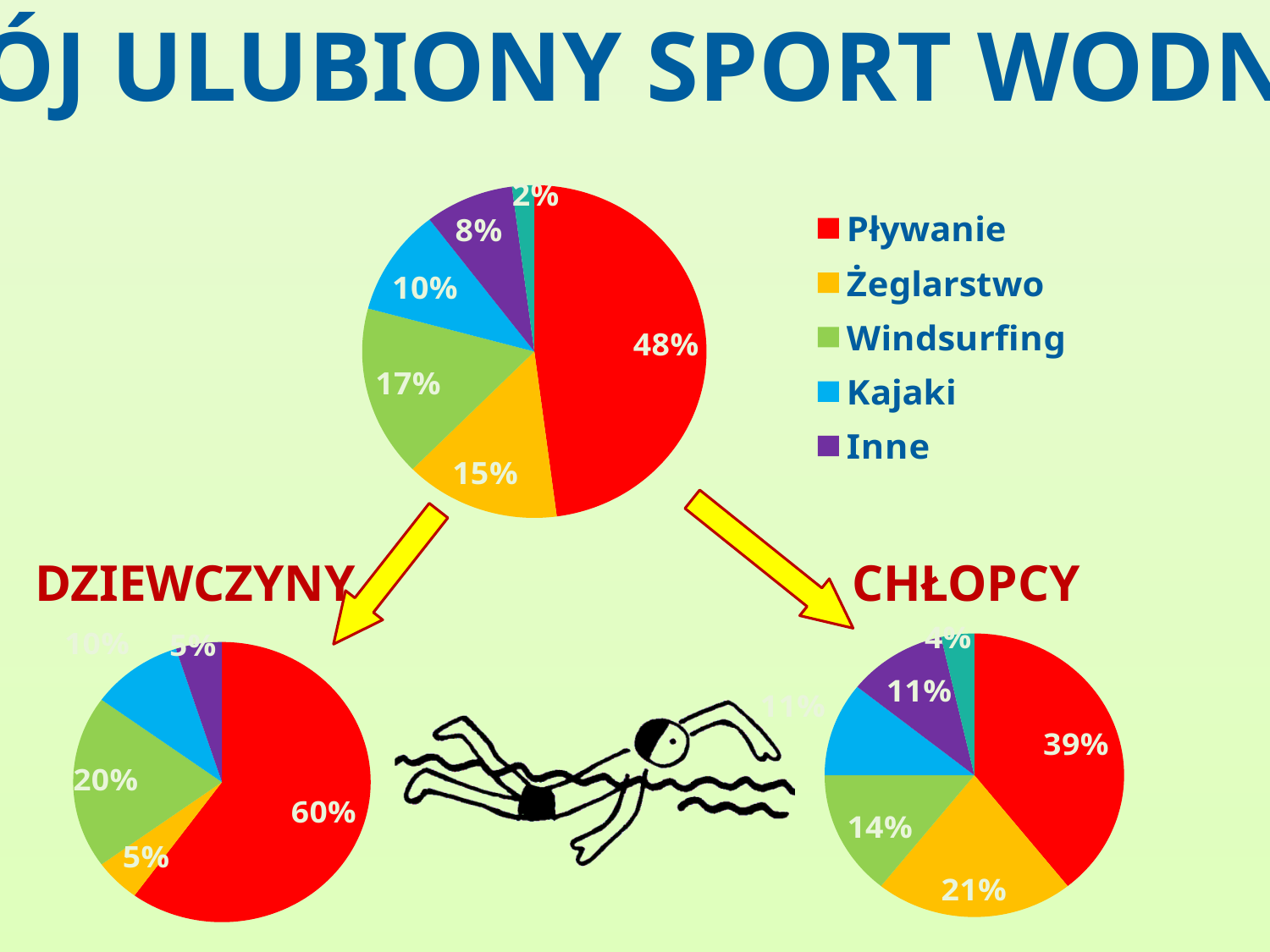
Which is larger: the share of Pływanie in the DZIEWCZYNY chart or in the CHŁOPCY chart? DZIEWCZYNY In the CHŁOPCY pie chart, what share does Windsurfing have? 14% Which colour represents Kajaki in the legend? blue In the top pie chart, which category has the largest share? Pływanie In the top pie chart, what is the difference between the shares of Żeglarstwo and Inne? 7% In the top pie chart, what share does Pływanie have? 48% What type of chart is used on this slide? pie chart In the DZIEWCZYNY pie chart, what share does Pływanie have? 60% In the DZIEWCZYNY pie chart, what share does Windsurfing have? 20% In the top pie chart, what share does Windsurfing have? 17% In the CHŁOPCY pie chart, what share does Żeglarstwo have? 21% How many entries does the legend list? 5